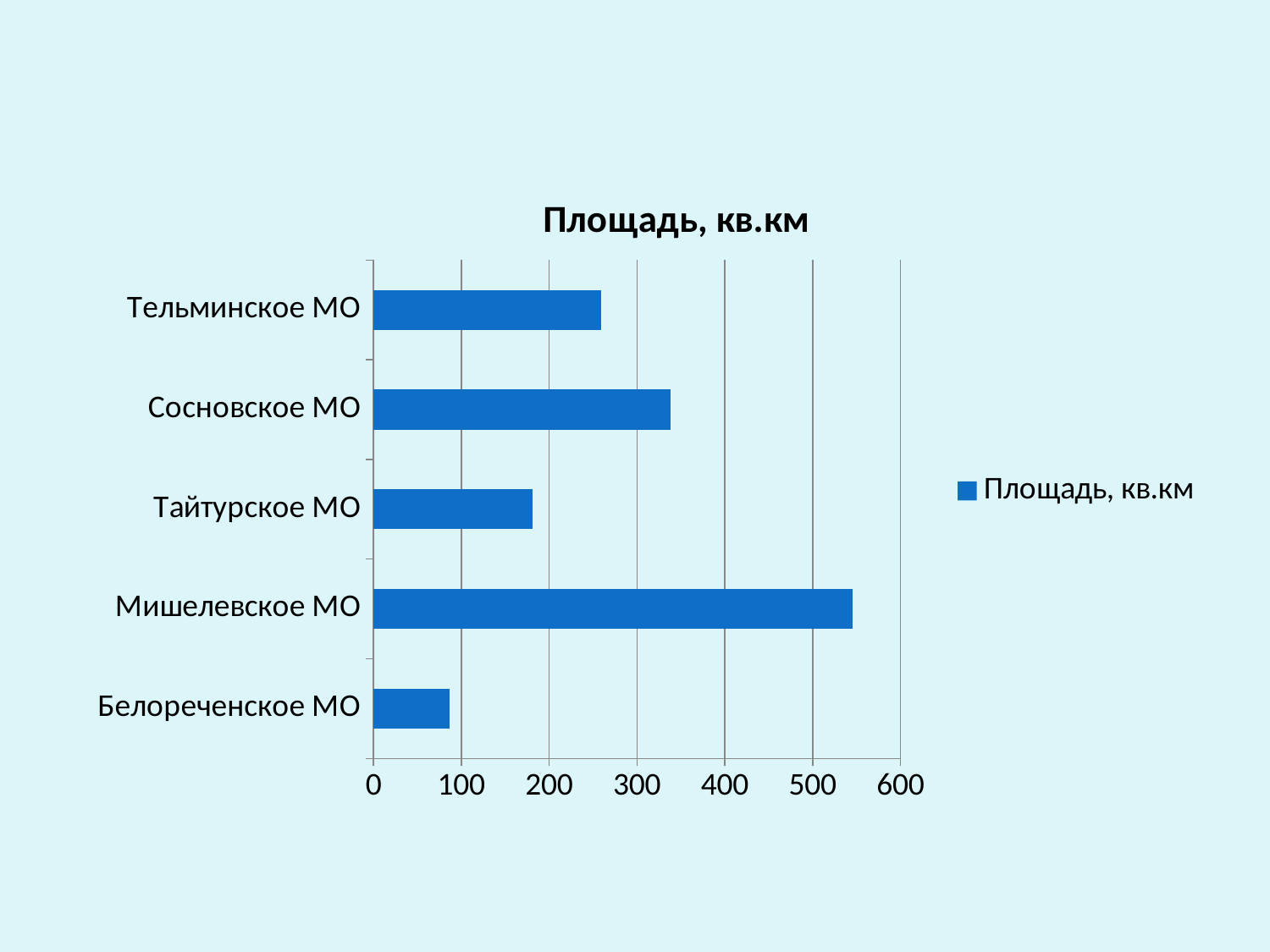
Is the value for Мишелевское МО greater or less than 500? greater How many series does the legend list? 1 Is the value for Тельминское МО greater or less than 200? greater What kind of chart is shown on the slide? Bar chart Which category has the lowest value? Белореченское МО How many categories are plotted in the chart? 5 Which category has the highest value? Мишелевское МО What is the title of the chart? Площадь, кв.км Which is larger, the value for Тайтурское МО or the value for Белореченское МО? Тайтурское МО Is the value for Сосновское МО greater or less than 300? greater Which is larger, the value for Сосновское МО or the value for Тельминское МО? Сосновское МО